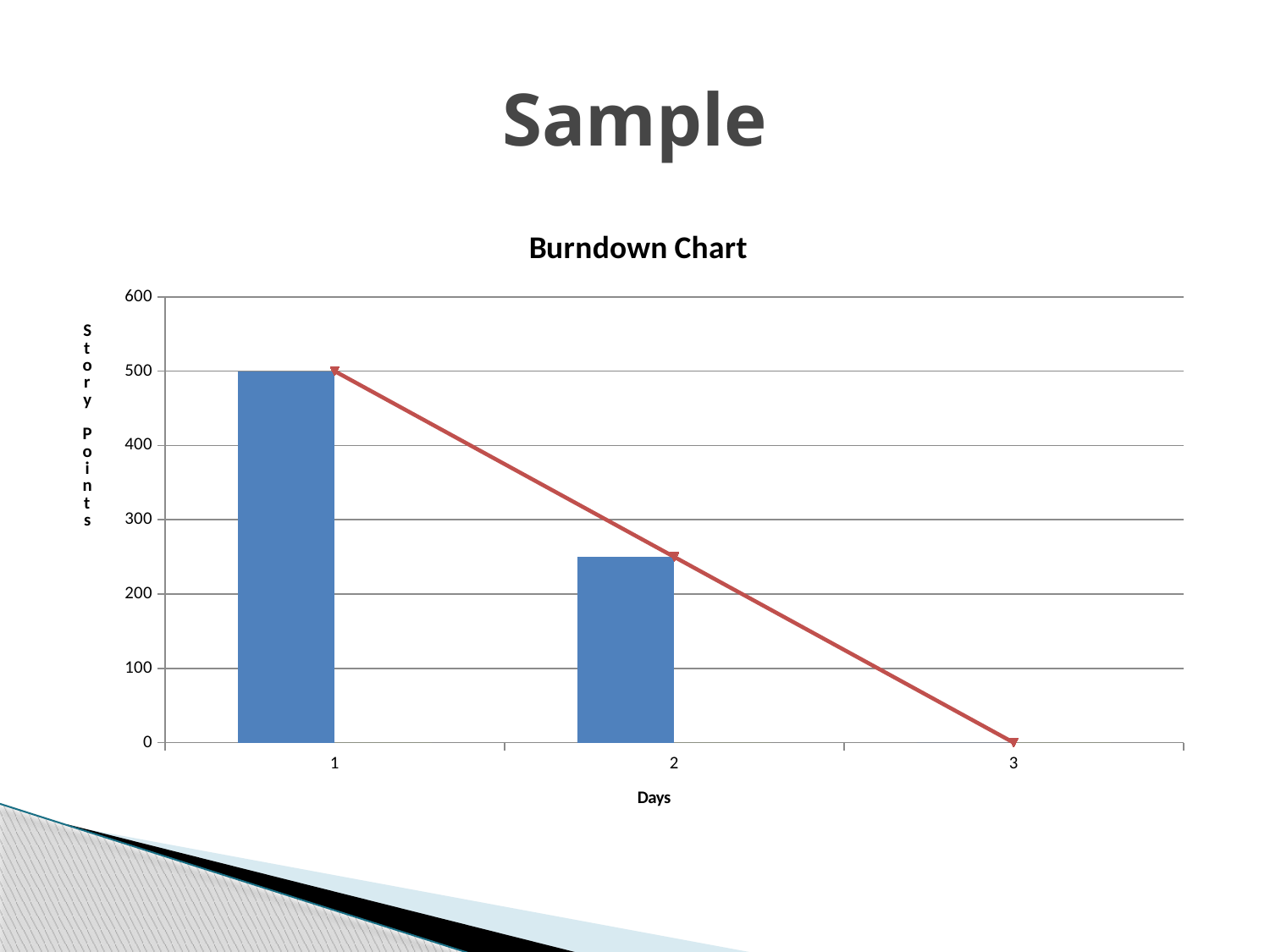
What kind of chart is shown on the slide? A bar chart combined with a line What is the title of the chart? Burndown Chart Is the value of the bar for day 2 greater or less than 300? less What is the label of the horizontal axis? Days How many days are shown on the x axis? 3 How many bars are plotted in the chart? 2 What is the story points value of the bar for day 1? 500 Which bar is taller, day 1 or day 2? Day 1 Is the value of the bar for day 2 greater or less than 200? greater Which day has the tallest bar? Day 1 Does the red line rise or fall from day 1 to day 3? It falls What value does the red line reach at day 3? 0